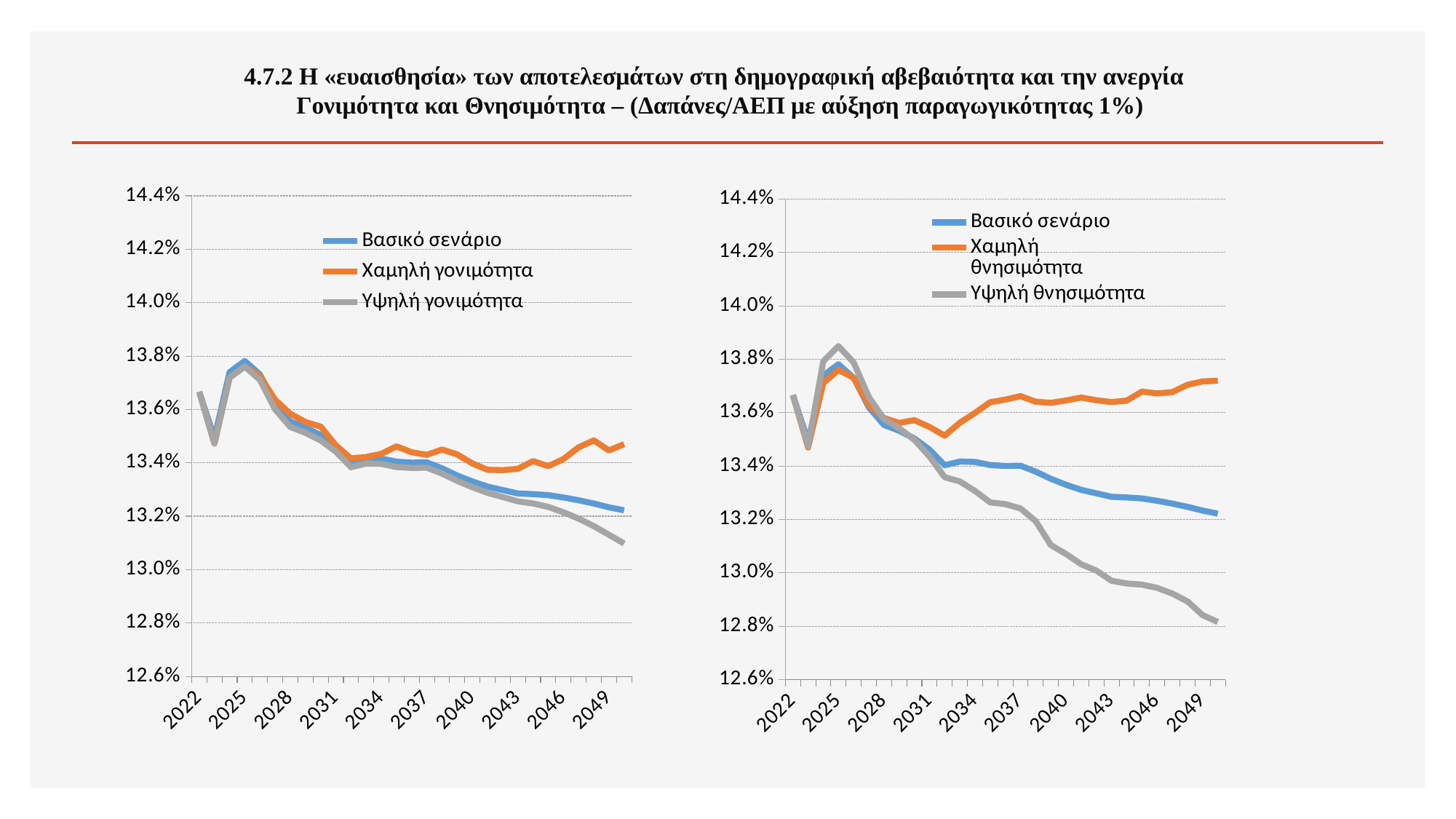
In the left chart (fertility scenarios), is the value for Χαμηλή γονιμότητα in 2049 greater or less than 13.4%? greater In the left chart (fertility scenarios), is the value for Υψηλή γονιμότητα in 2049 greater or less than 13.2%? less In the left chart (fertility scenarios), which series is higher in 2049: Χαμηλή γονιμότητα or Υψηλή γονιμότητα? Χαμηλή γονιμότητα What kind of chart is the left chart (fertility scenarios)? Line chart In the left chart (fertility scenarios), does the Βασικό σενάριο line rise or fall from 2025 to 2049? Fall In the right chart (mortality scenarios), which series is higher in 2049: Χαμηλή θνησιμότητα or Υψηλή θνησιμότητα? Χαμηλή θνησιμότητα In the right chart (mortality scenarios), does the Υψηλή θνησιμότητα line rise or fall from 2025 to 2049? Fall In the right chart (mortality scenarios), is the value for Υψηλή θνησιμότητα in 2049 greater or less than 13.0%? less In the right chart (mortality scenarios), what colour is the Βασικό σενάριο line? Blue How many series does the legend of the left chart (fertility scenarios) list? 3 How many series does the legend of the right chart (mortality scenarios) list? 3